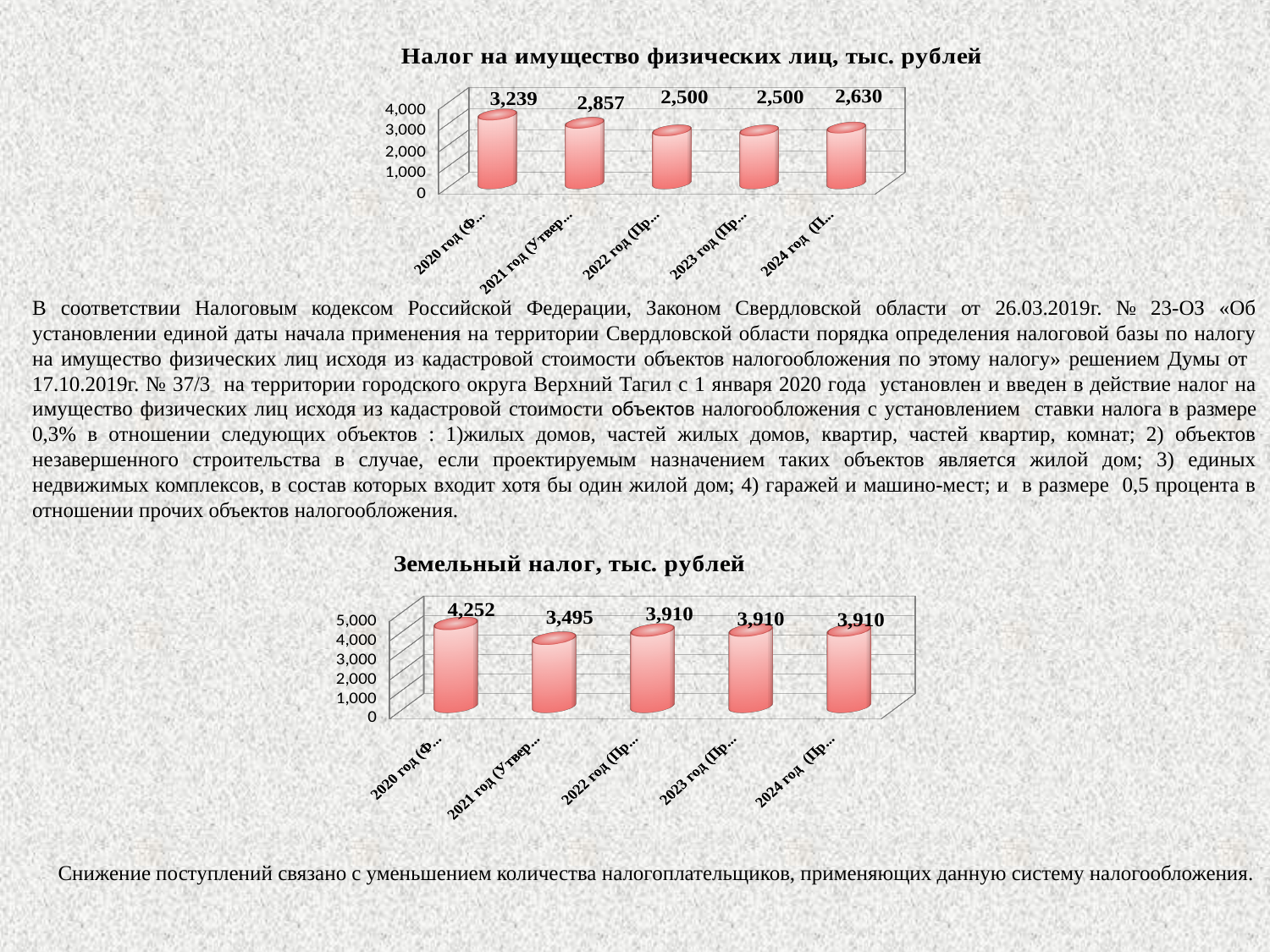
In the chart titled "Земельный налог, тыс. рублей", which year has the lowest value? 2021 год In the chart titled "Налог на имущество физических лиц, тыс. рублей", is the value for 2022 год greater or less than 3,000? less In the chart titled "Земельный налог, тыс. рублей", what is the value for 2021 год? 3,495 In the chart titled "Налог на имущество физических лиц, тыс. рублей", how many bars are plotted? 5 In the chart titled "Налог на имущество физических лиц, тыс. рублей", which year has the highest value? 2020 год In the chart titled "Налог на имущество физических лиц, тыс. рублей", what is the value for 2024 год? 2,630 In the chart titled "Земельный налог, тыс. рублей", which is larger: the value for 2021 год or the value for 2022 год? 2022 год In the chart titled "Земельный налог, тыс. рублей", what is the difference between the 2020 год and 2024 год values? 342 In the chart titled "Налог на имущество физических лиц, тыс. рублей", what is the difference between the 2020 год and 2021 год values? 382 What kind of chart is the one titled "Земельный налог, тыс. рублей"? Bar chart In the chart titled "Налог на имущество физических лиц, тыс. рублей", what is the value for 2020 год? 3,239 In the chart titled "Земельный налог, тыс. рублей", what is the value for 2020 год? 4,252